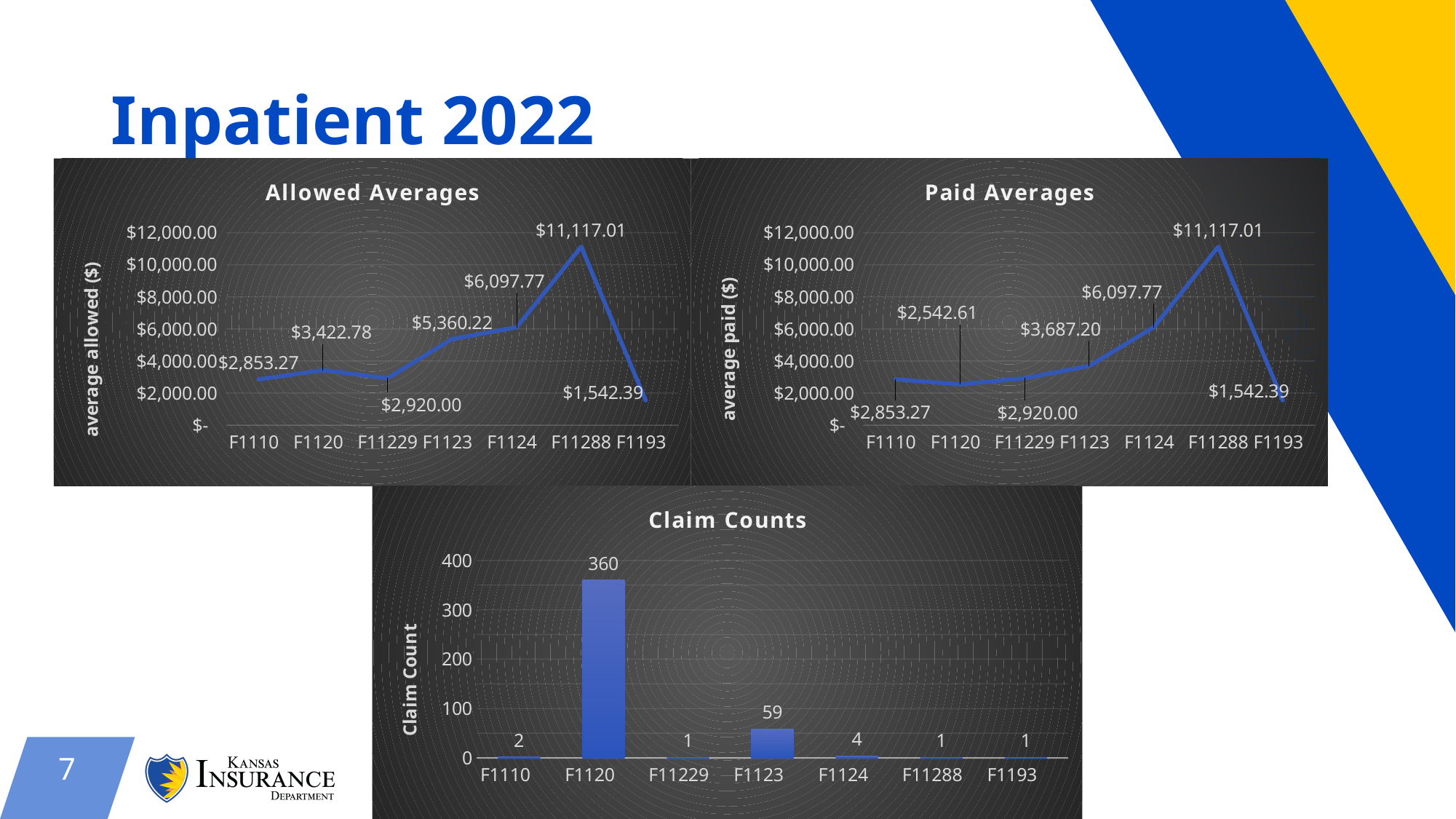
In the Allowed Averages chart, what is the value for F11288? $11,117.01 In the Allowed Averages chart, which category has the lowest value? F1193 What is the y-axis title of the Paid Averages chart? average paid ($) In the Allowed Averages chart, what is the difference between the values for F1124 and F1123? $737.55 What kind of chart is the Claim Counts chart? bar chart What kind of chart is the Allowed Averages chart? line chart In the Claim Counts chart, which category has the highest claim count? F1120 In the Claim Counts chart, what is the difference between the claim counts for F1120 and F1123? 301 In the Claim Counts chart, what is the claim count for F1120? 360 Is the value for F1123 larger in the Allowed Averages chart or in the Paid Averages chart? Allowed Averages In the Paid Averages chart, what is the value for F1120? $2,542.61 How many categories are shown on the x axis of the Allowed Averages chart? 7